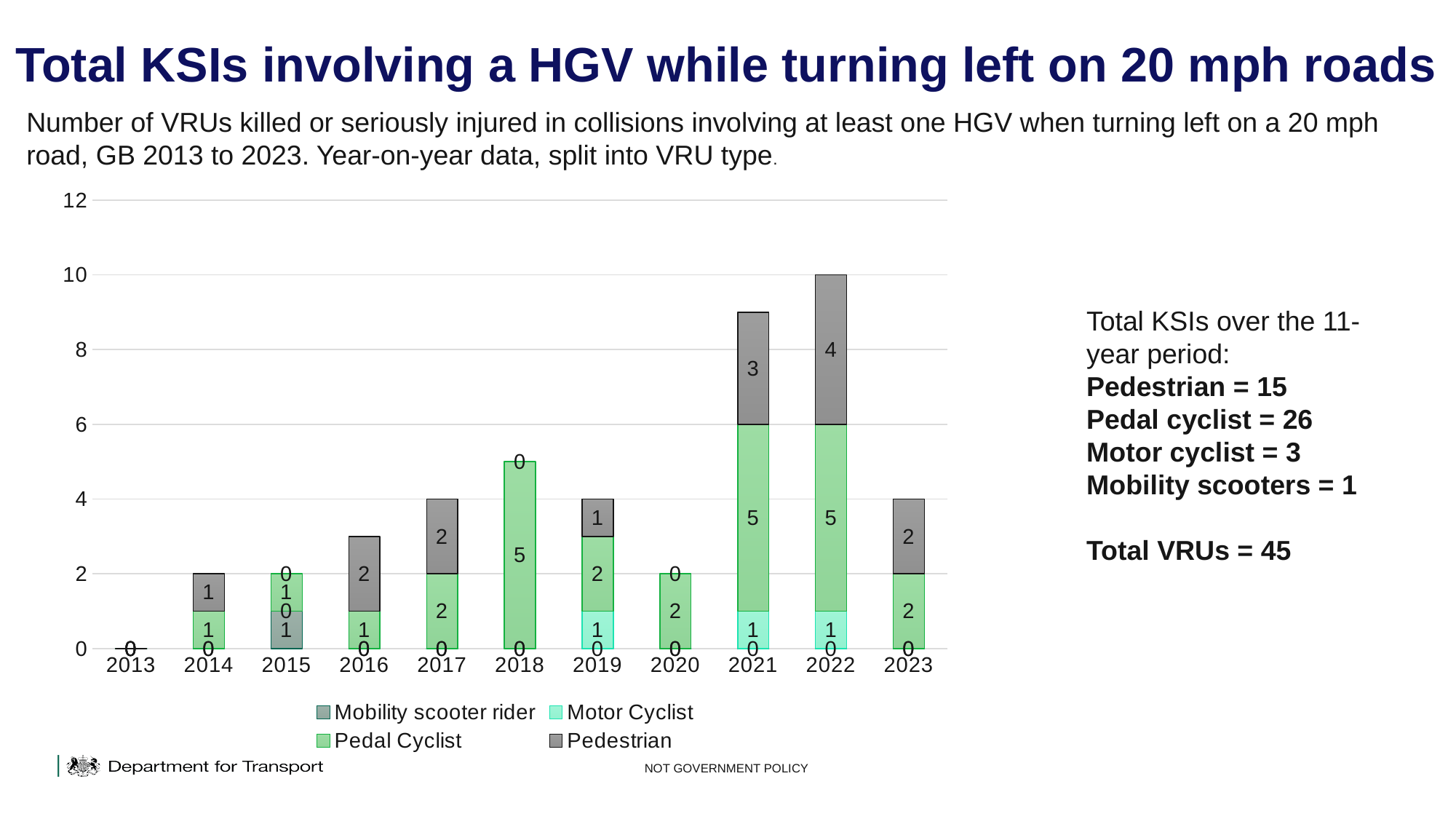
Which is larger, the Pedal Cyclist value for 2018 or the Pedal Cyclist value for 2017? 2018 What is the total of the stacked bar for 2021? 9 According to the text on the slide, what is the total number of VRUs over the 11-year period? 45 What is the Pedestrian value for 2022? 4 What is the Motor Cyclist value for 2019? 1 How many series does the legend list? 4 How many years are shown on the x axis? 11 What is the Pedestrian value for 2021? 3 What kind of chart is shown on the slide? Stacked bar chart What is the Pedal Cyclist value for 2018? 5 Which year has the highest total KSIs? 2022 What is the difference between the Pedestrian values for 2022 and 2021? 1